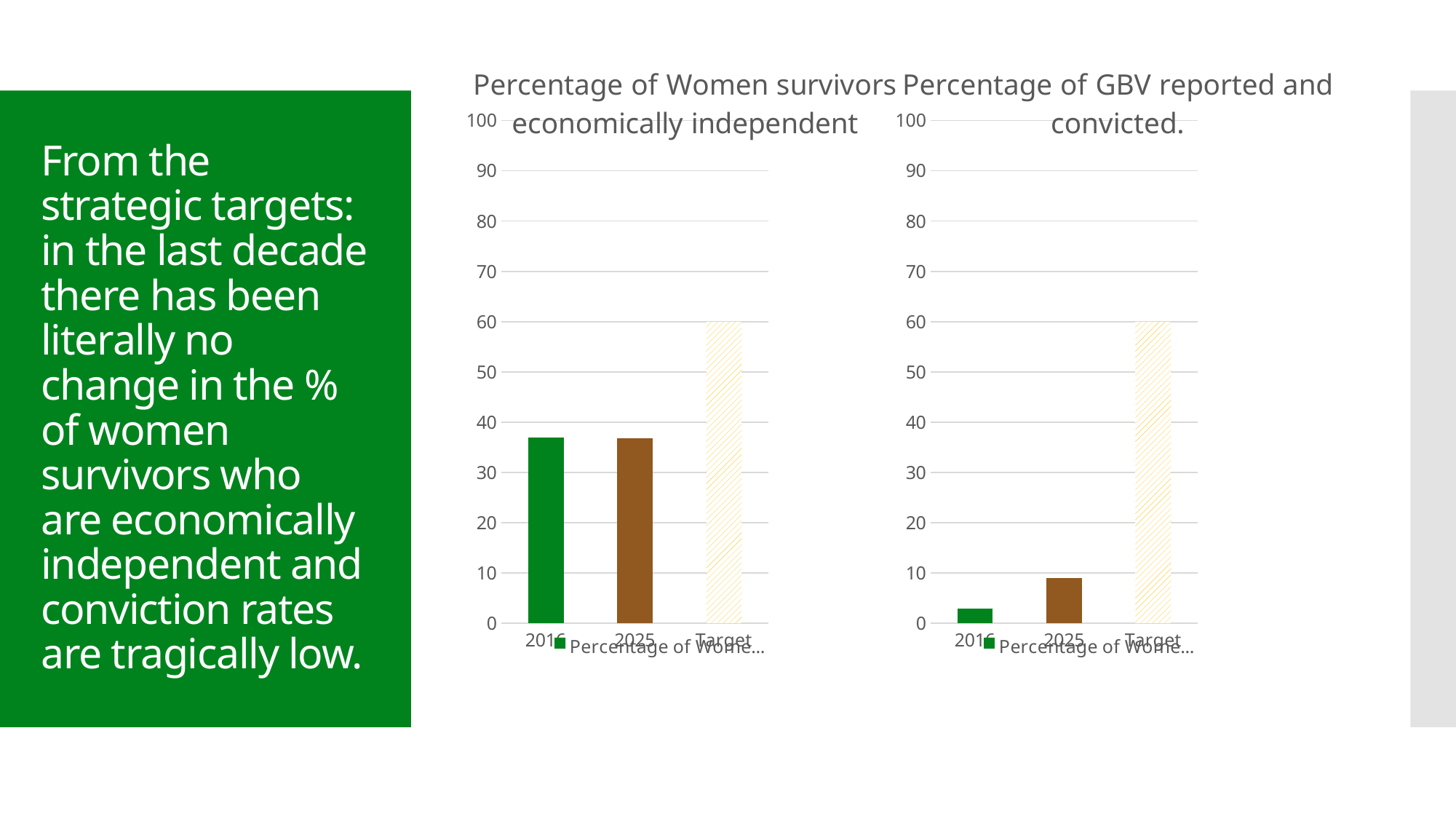
In the chart titled 'Percentage of Women survivors economically independent', which category has the highest value? Target In the chart titled 'Percentage of Women survivors economically independent', which is larger, the value for 2025 or the value for Target? Target In the chart titled 'Percentage of Women survivors economically independent', what is the value for Target? 60 What kind of chart is the chart titled 'Percentage of Women survivors economically independent'? bar chart What is the title of the chart on the right side of the slide? Percentage of GBV reported and convicted. In the chart titled 'Percentage of GBV reported and convicted.', is the value for 2025 greater or less than 10? less In the chart titled 'Percentage of GBV reported and convicted.', which category has the highest value? Target How many categories are shown on the x axis of the chart titled 'Percentage of Women survivors economically independent'? 3 In the chart titled 'Percentage of GBV reported and convicted.', what is the value for Target? 60 In the chart titled 'Percentage of GBV reported and convicted.', which is larger, the value for 2025 or the value for Target? Target In the chart titled 'Percentage of Women survivors economically independent', is the value for 2025 greater or less than 40? less In the chart titled 'Percentage of Women survivors economically independent', is the value for 2025 greater or less than 30? greater